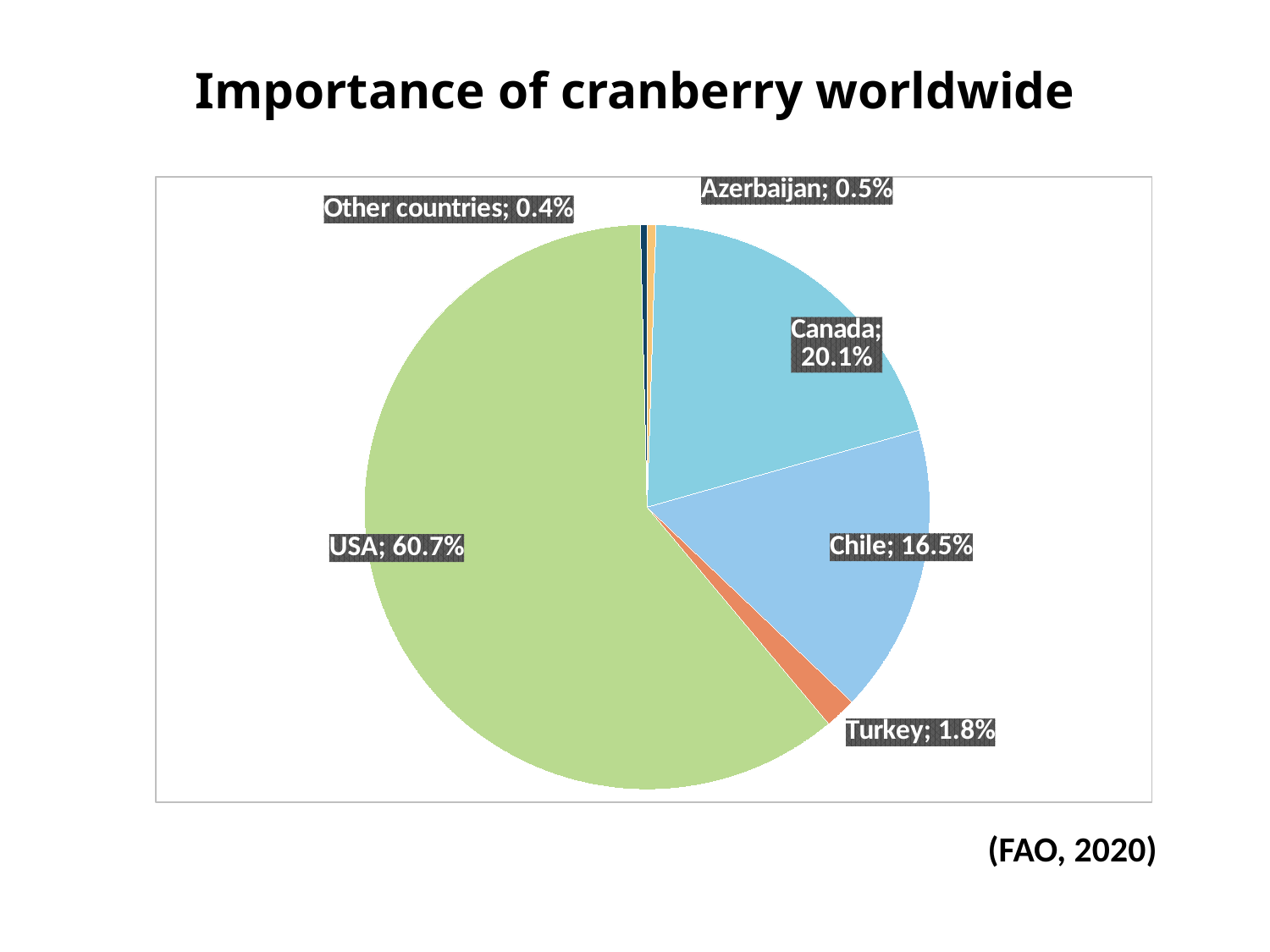
What is the difference between the shares of Canada and Chile? 3.6% What is the value shown for Azerbaijan? 0.5% What share of the pie does the USA hold? 60.7% What is the value shown for Chile? 16.5% Which has a larger share, Canada or Chile? Canada Which category has the smallest slice of the pie? Other countries What is the value shown for Canada? 20.1% What is the value shown for Turkey? 1.8% What kind of chart is shown on the slide? Pie chart Which category has the largest slice of the pie? USA What is the title of the slide containing the chart? Importance of cranberry worldwide How many slices does the pie chart have? 6